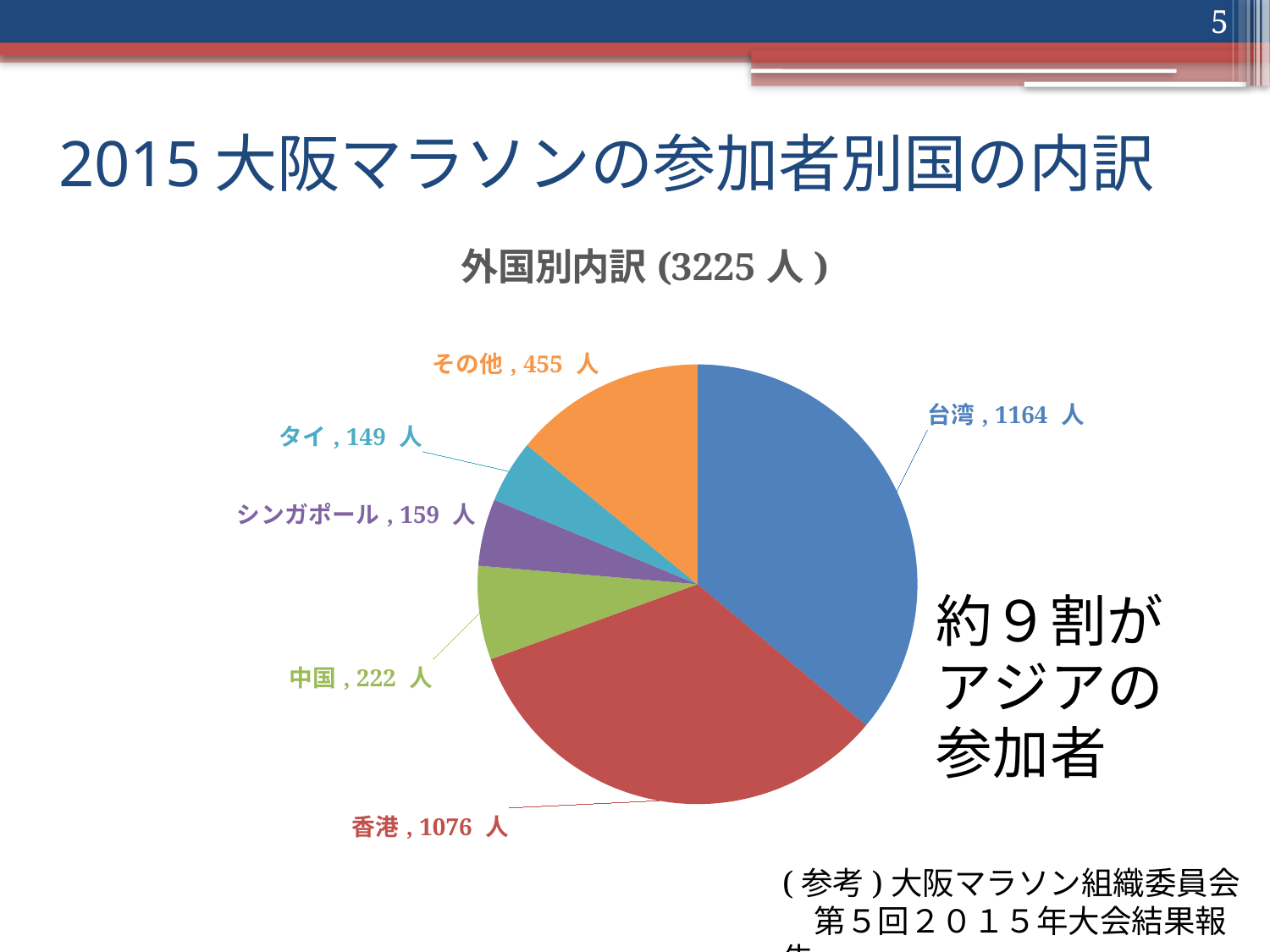
What is the difference between the values for その他 and 中国? 233 人 What is the value shown for シンガポール? 159 人 What is the total number of participants given in the chart title? 3225 人 What kind of chart is shown on the slide? pie chart What is the difference between the values for 台湾 and 香港? 88 人 What is the value shown for 香港 in the pie chart? 1076 人 Which category has the largest slice in the pie chart? 台湾 What is the value shown for その他? 455 人 Which category has the smallest slice in the pie chart? タイ How many slices does the pie chart have? 6 How many participants from 台湾 are shown in the pie chart? 1164 人 Which is larger, the value for シンガポール or the value for タイ? シンガポール